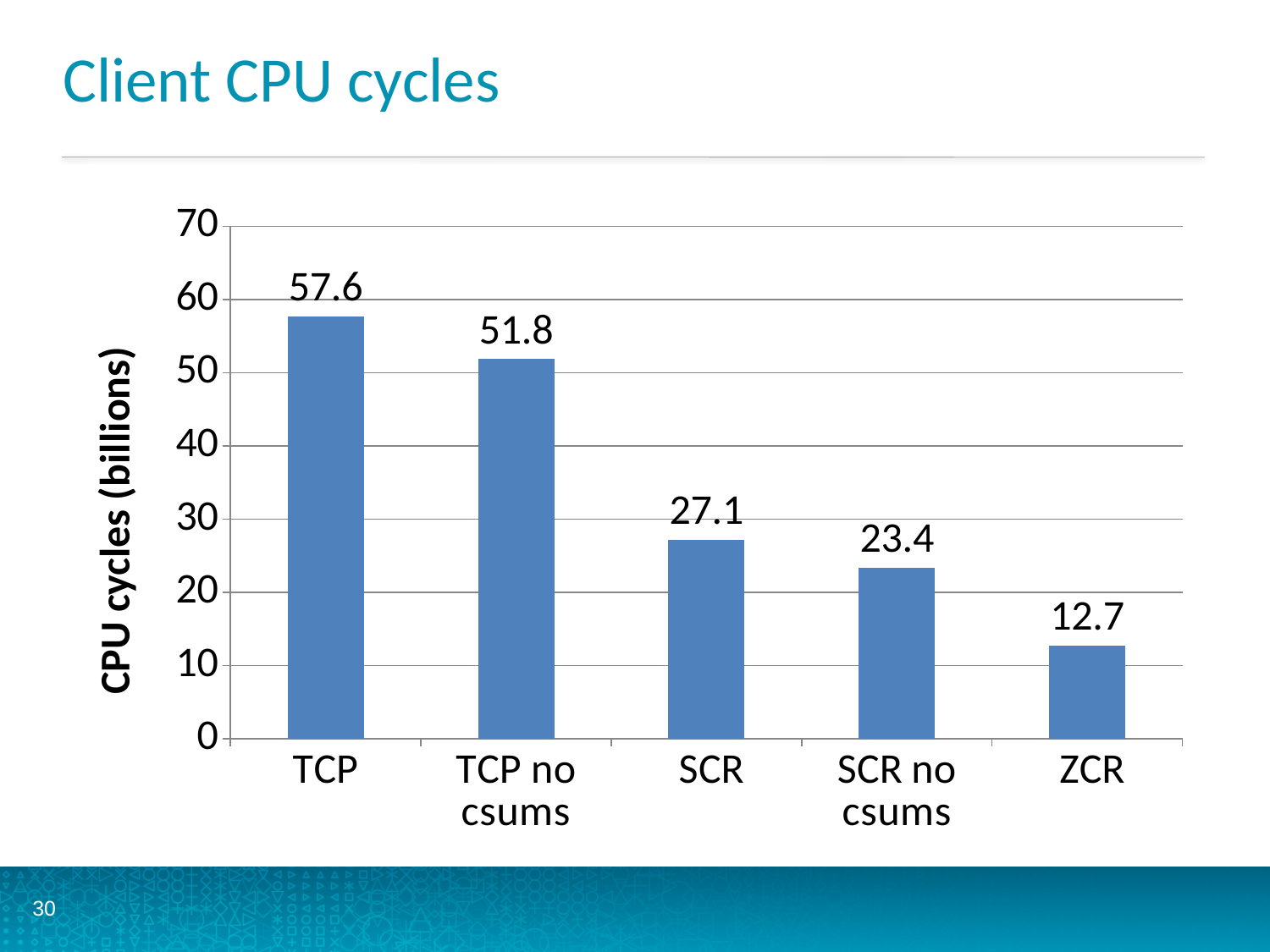
What is the value for TCP? 57.6 What is the value for ZCR? 12.7 Is the value for TCP no csums greater or less than 50? greater What kind of chart is shown on the slide? bar chart What is the label of the y axis? CPU cycles (billions) Which category has the highest CPU cycles? TCP What is the difference between the values for TCP and TCP no csums? 5.8 Which category has the lowest CPU cycles? ZCR What is the value for SCR no csums? 23.4 What is the difference between the values for SCR and ZCR? 14.4 Which is larger, the value for SCR or the value for SCR no csums? SCR How many categories are shown on the x axis? 5